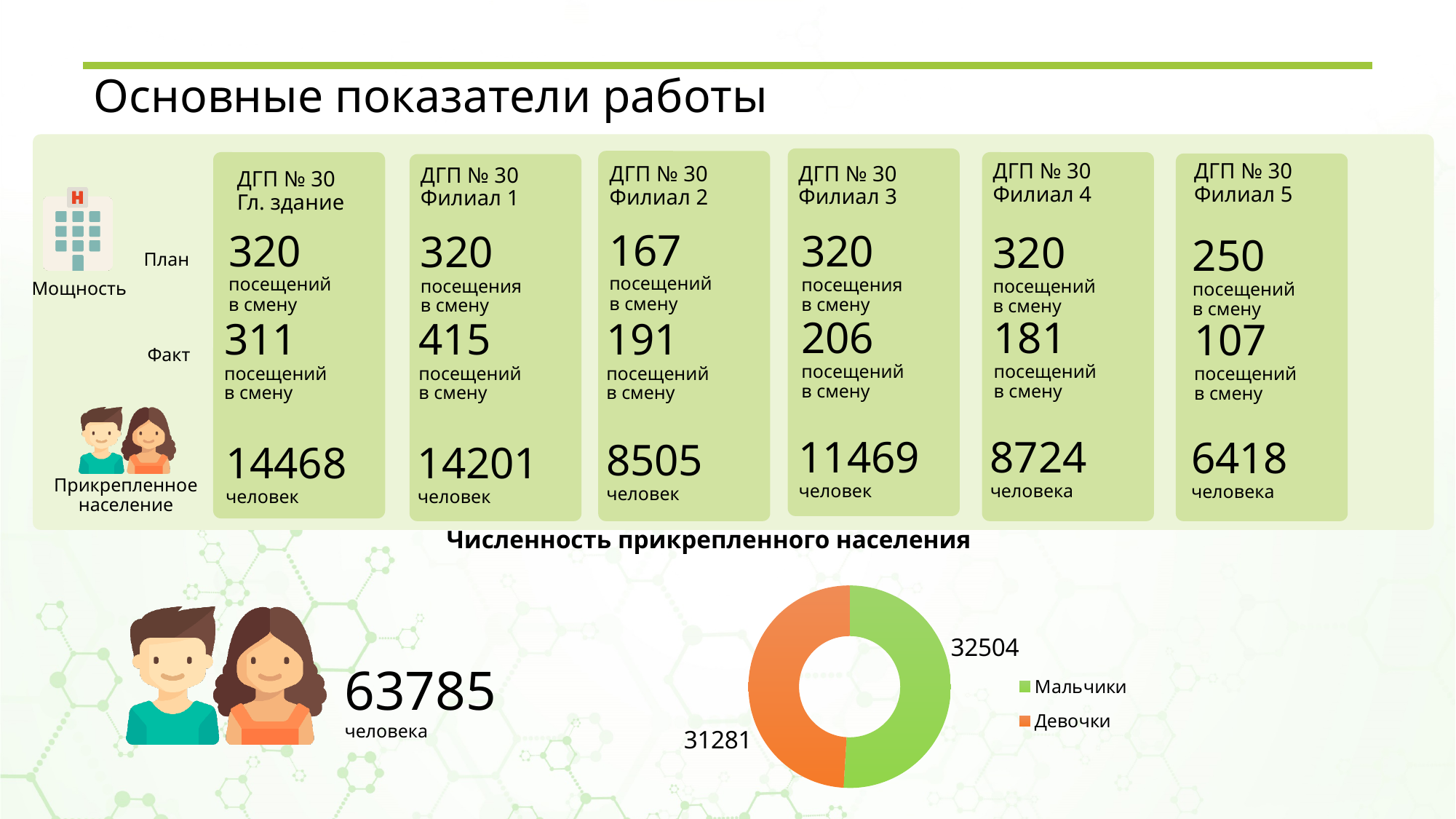
What is the difference between the Мальчики and Девочки values in the donut chart? 1223 What colour represents Девочки in the donut chart? Orange In the donut chart, what is the value for Мальчики? 32504 In the donut chart, what is the value for Девочки? 31281 Which category has the smallest value in the donut chart? Девочки What kind of chart is shown under the heading 'Численность прикрепленного населения'? Donut (pie) chart How many entries does the legend of the donut chart list? 2 What is the total of the two slices in the donut chart? 63785 Which slice of the donut chart is larger, Мальчики or Девочки? Мальчики How many categories does the donut chart show? 2 Which category has the largest value in the donut chart? Мальчики What is the title of the donut chart? Численность прикрепленного населения